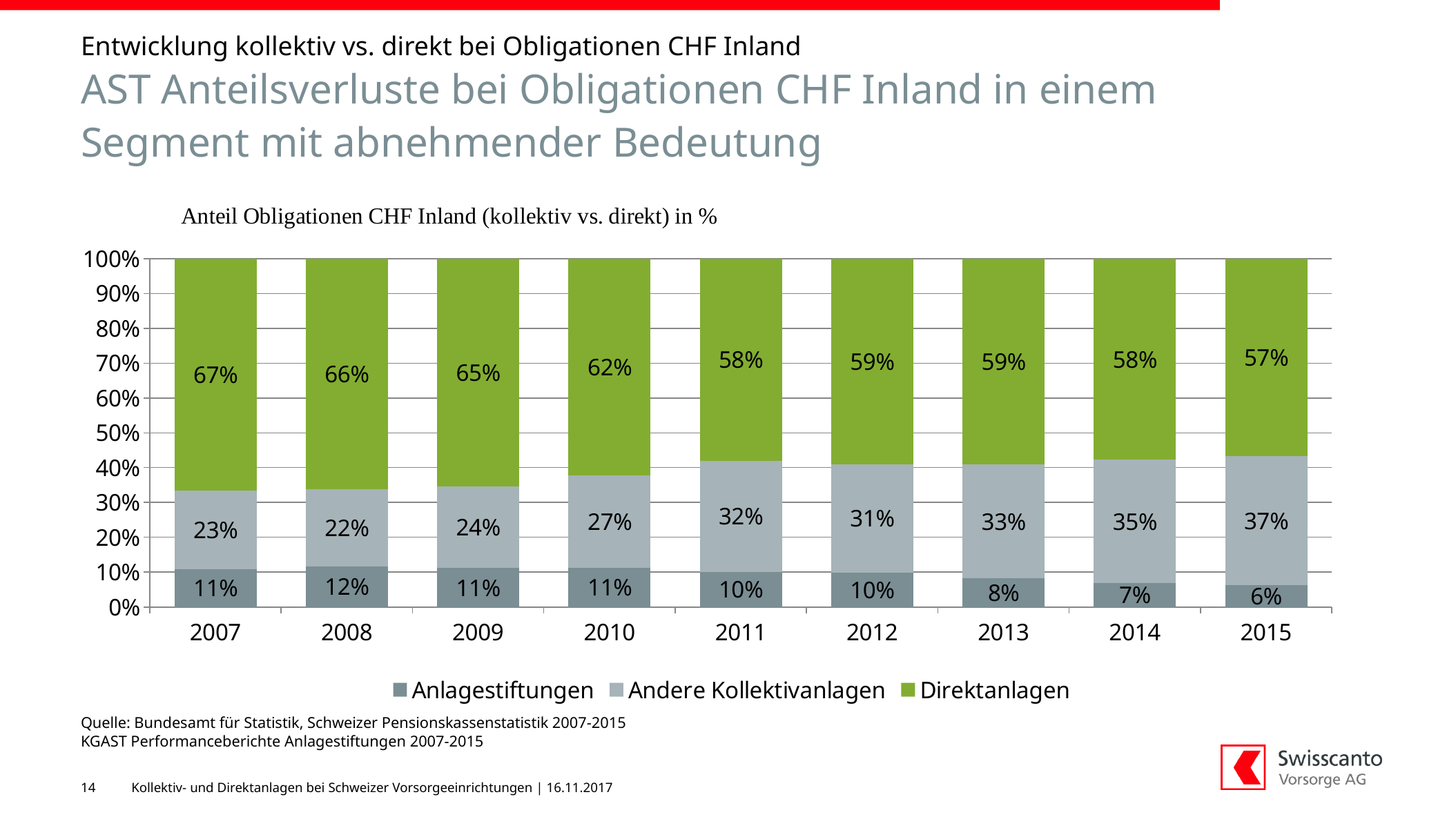
How many series does the legend list? 3 Which is larger: Andere Kollektivanlagen in 2011 or in 2012? 2011 What kind of chart is shown? Stacked bar chart In which year is the Andere Kollektivanlagen share highest? 2015 In which year is the Anlagestiftungen share lowest? 2015 What is the value for Direktanlagen in 2007? 67% What is the value for Andere Kollektivanlagen in 2015? 37% How many years are shown on the x axis? 9 Does the Anlagestiftungen share rise or fall from 2010 to 2015? Fall What is the value for Anlagestiftungen in 2008? 12% What is the title of the chart? Anteil Obligationen CHF Inland (kollektiv vs. direkt) in % What is the difference between the Direktanlagen share in 2007 and in 2015? 10%